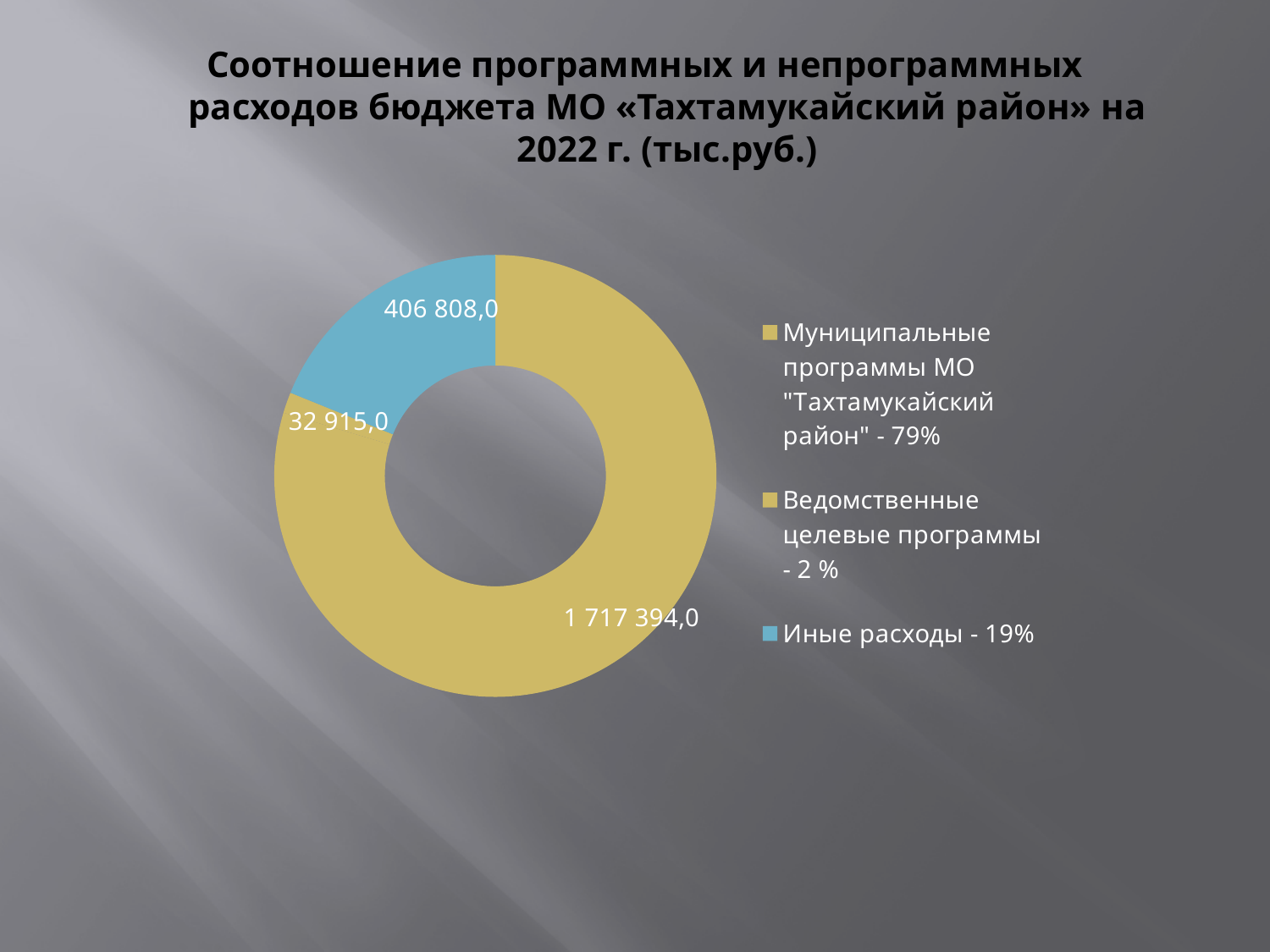
What share of the total do «Муниципальные программы МО "Тахтамукайский район"» make up, according to the legend? 79% What value is shown for «Муниципальные программы МО "Тахтамукайский район"»? 1 717 394,0 What kind of chart is shown on the slide? Doughnut (ring) chart How many categories does the chart show? 3 Which is larger: «Иные расходы» or «Ведомственные целевые программы»? Иные расходы Which category has the largest value in the chart? Муниципальные программы МО "Тахтамукайский район" What share of the total do «Иные расходы» make up, according to the legend? 19% What value is shown for «Ведомственные целевые программы»? 32 915,0 What is the difference between the value for «Муниципальные программы МО "Тахтамукайский район"» and the value for «Иные расходы»? 1 310 586,0 What value is shown for «Иные расходы»? 406 808,0 Which category has the smallest value in the chart? Ведомственные целевые программы What is the difference between the value for «Иные расходы» and the value for «Ведомственные целевые программы»? 373 893,0